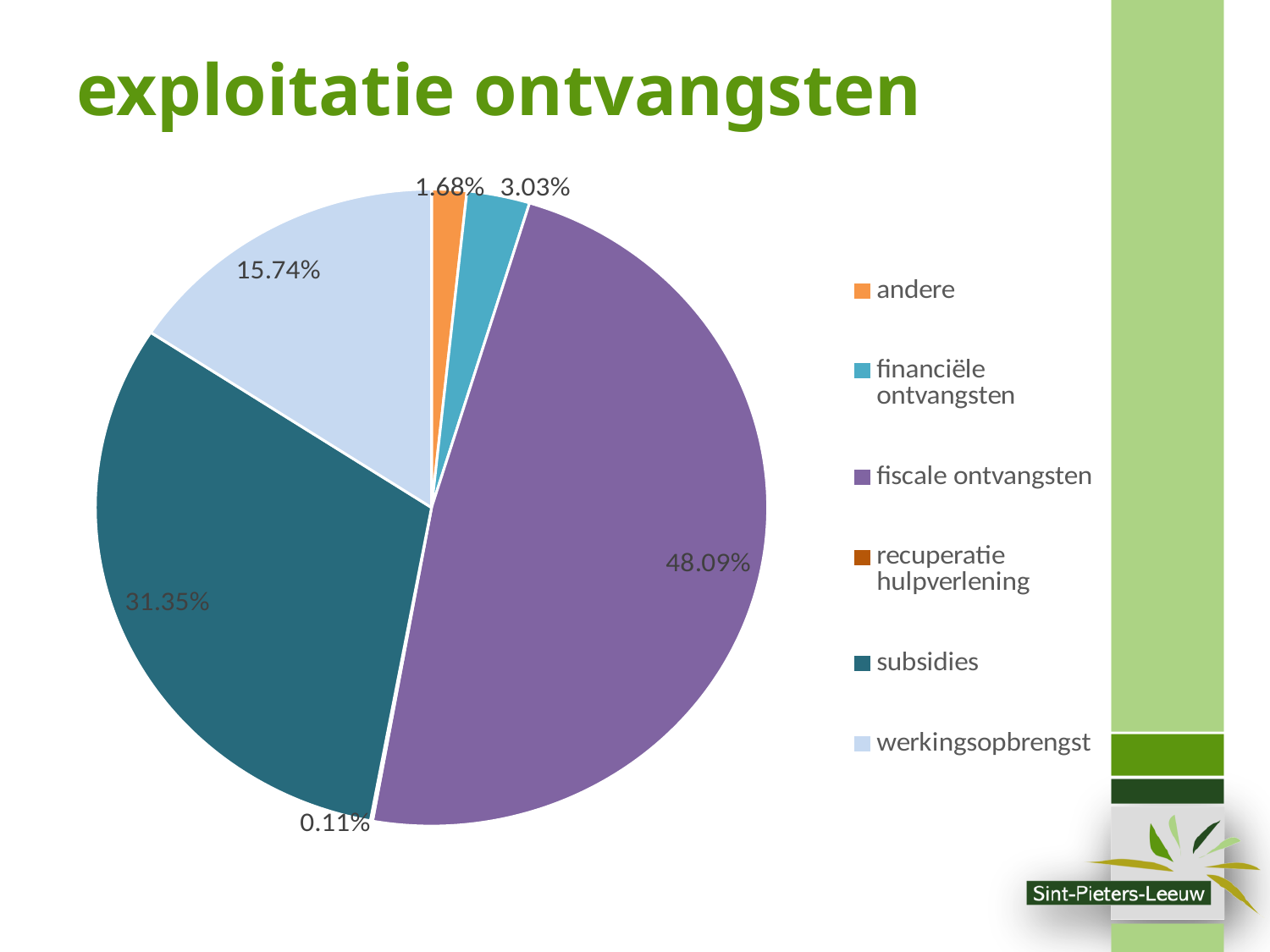
What kind of chart is shown on the slide? pie chart What share of the pie does subsidies represent? 31.35% How many categories does the legend list? 6 Which is larger, the share for werkingsopbrengst or the share for financiële ontvangsten? werkingsopbrengst Which category has the largest share of the pie? fiscale ontvangsten What share of the pie does andere represent? 1.68% What share of the pie does fiscale ontvangsten represent? 48.09% Which category has the smallest share of the pie? recuperatie hulpverlening What is the difference in percentage points between fiscale ontvangsten and subsidies? 16.74